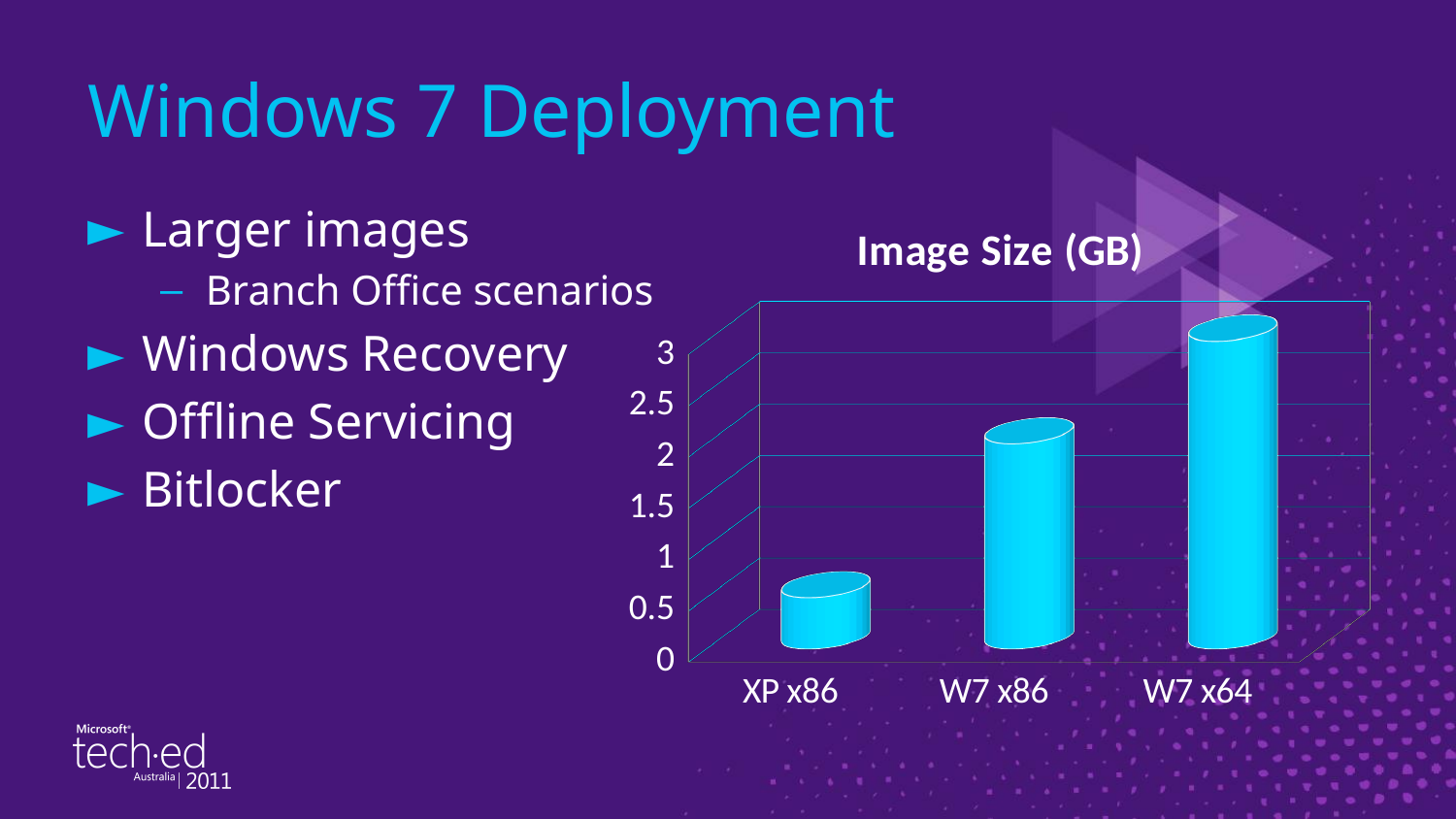
Which category has the smallest image size? XP x86 Do the image sizes rise or fall from XP x86 to W7 x64 along the x axis? rise Is the value for W7 x86 greater or less than 3? less How many categories are shown on the x axis of the chart? 3 Which has a larger image size, XP x86 or W7 x86? W7 x86 Is the value for W7 x86 greater or less than 1.5? greater Which category has the largest image size? W7 x64 What is the title of the chart? Image Size (GB) Is the value for W7 x64 greater or less than 2.5? greater What kind of chart is shown on the slide? bar chart Which has a larger image size, W7 x86 or W7 x64? W7 x64